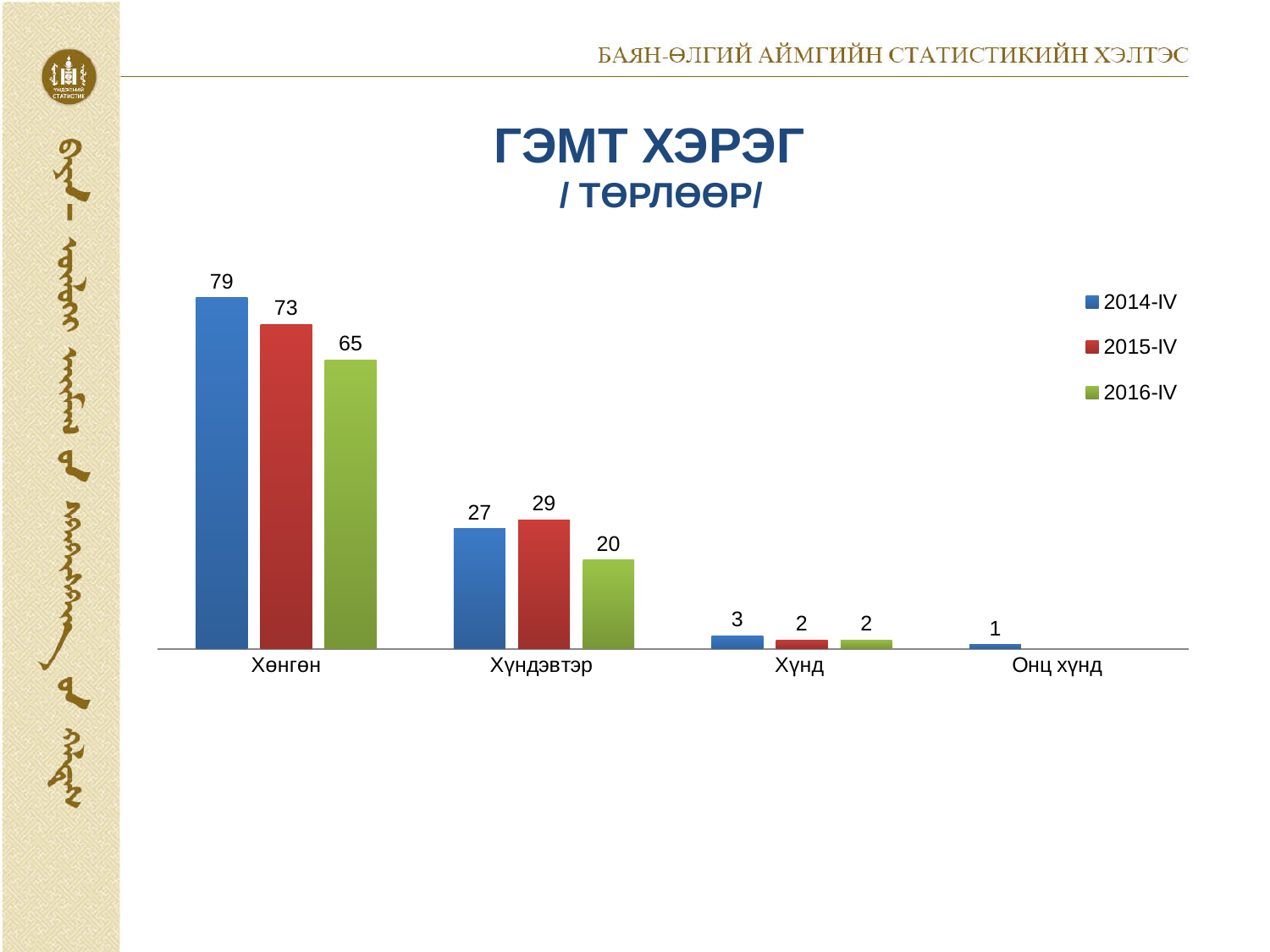
How many series does the legend list? 3 For Хүндэвтэр, which is larger: the 2014-IV value or the 2015-IV value? 2015-IV Which category has the highest value in the 2015-IV series? Хөнгөн Do the values for the 2016-IV series rise or fall from Хөнгөн to Хүнд? Fall What is the value for Хөнгөн in the 2014-IV series? 79 What kind of chart is shown on the slide? Bar chart What is the difference between the 2014-IV and 2016-IV values for Хөнгөн? 14 Which category has the lowest value in the 2014-IV series? Онц хүнд How many categories are shown on the x axis? 4 What is the value for Хүнд in the 2015-IV series? 2 What is the value for Онц хүнд in the 2014-IV series? 1 What is the value for Хүндэвтэр in the 2016-IV series? 20